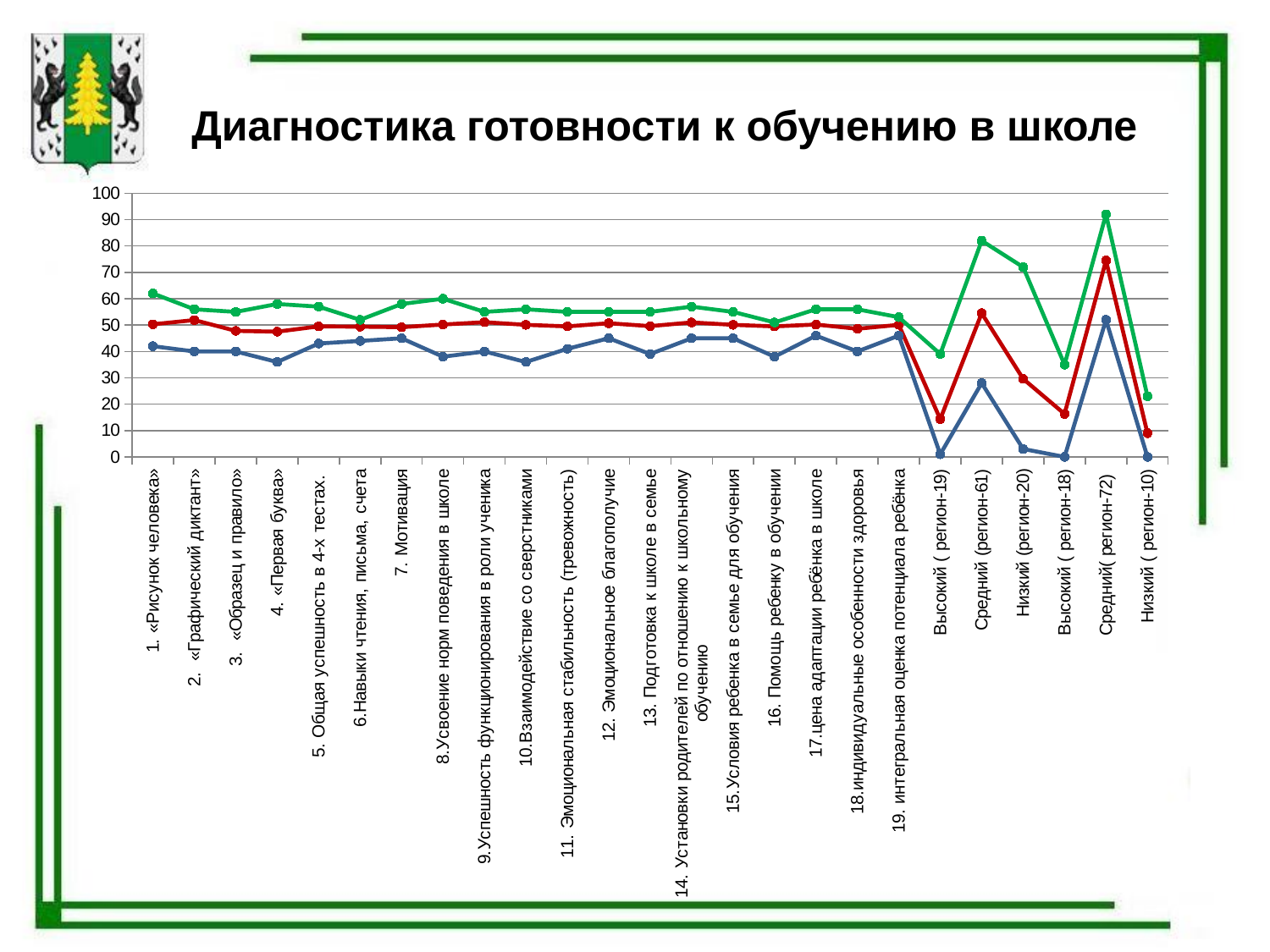
How many categories are shown along the x axis of the chart? 25 At which category does the green line reach its highest value? Средний( регион-72) For the green line, which is higher: the value at «Средний (регион-61)» or at «Низкий (регион-20)»? Средний (регион-61) Is the green line's value for «Низкий ( регион-10)» greater or less than 30? less Is the blue line's value for «4. «Первая буква»» greater or less than 40? less Is the green line's value for «8.Усвоение норм поведения в школе» greater or less than 50? greater What kind of chart is shown on the slide? line chart What is the title of the slide's chart? Диагностика готовности к обучению в школе How many lines (series) are plotted on the chart? 3